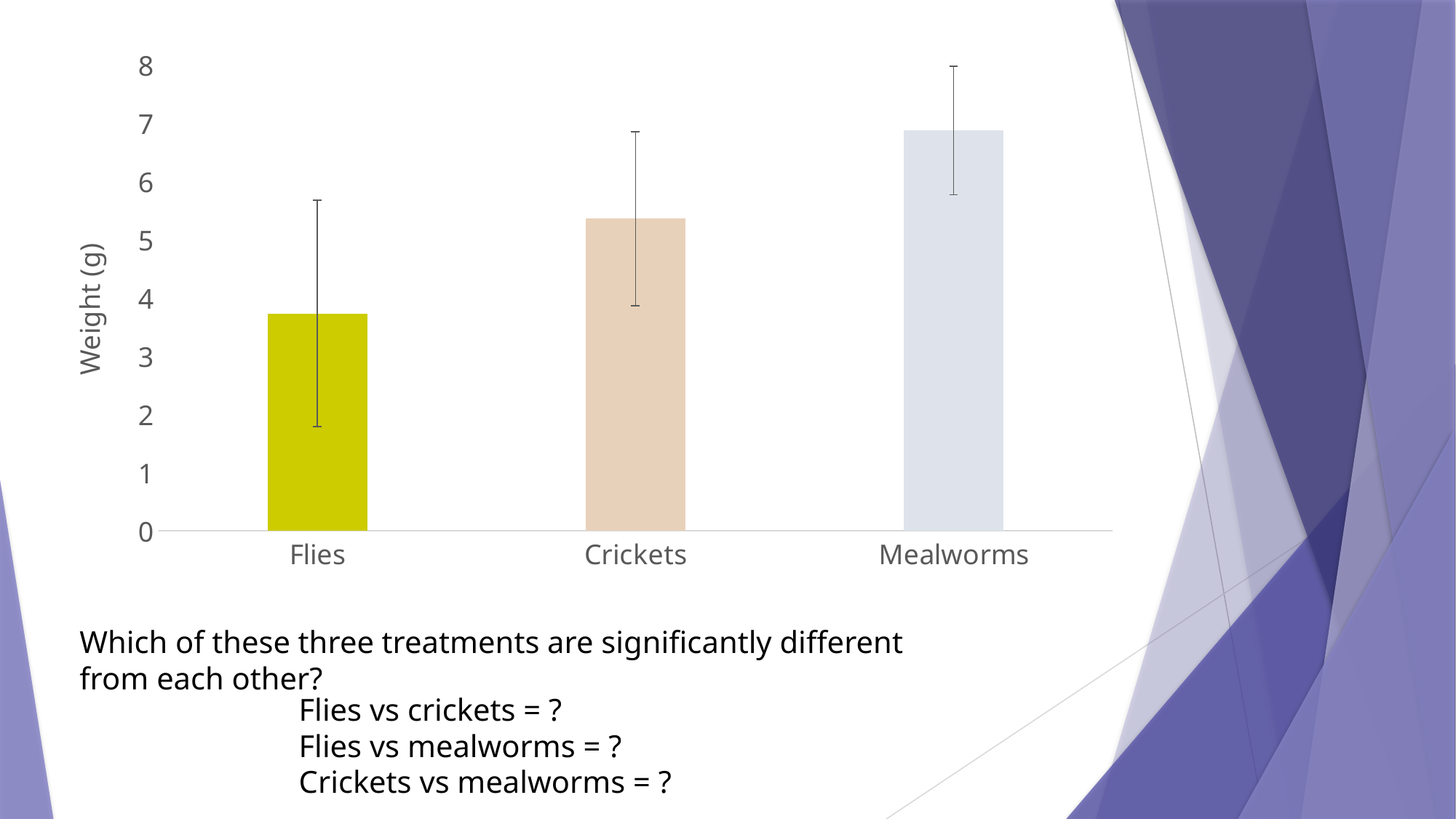
Is the weight for Mealworms greater or less than 6? greater Which category has the lowest weight? Flies Is the weight for Crickets greater or less than 5? greater Which category has the highest weight? Mealworms Is the weight for Flies greater or less than 3? greater Which has a larger weight, Crickets or Mealworms? Mealworms Which has a larger weight, Flies or Crickets? Crickets How many categories are shown on the x axis of the chart? 3 Do the bar values rise or fall from Flies to Mealworms along the x axis? rise What kind of chart is shown on the slide? bar chart What is the label of the y axis? Weight (g)